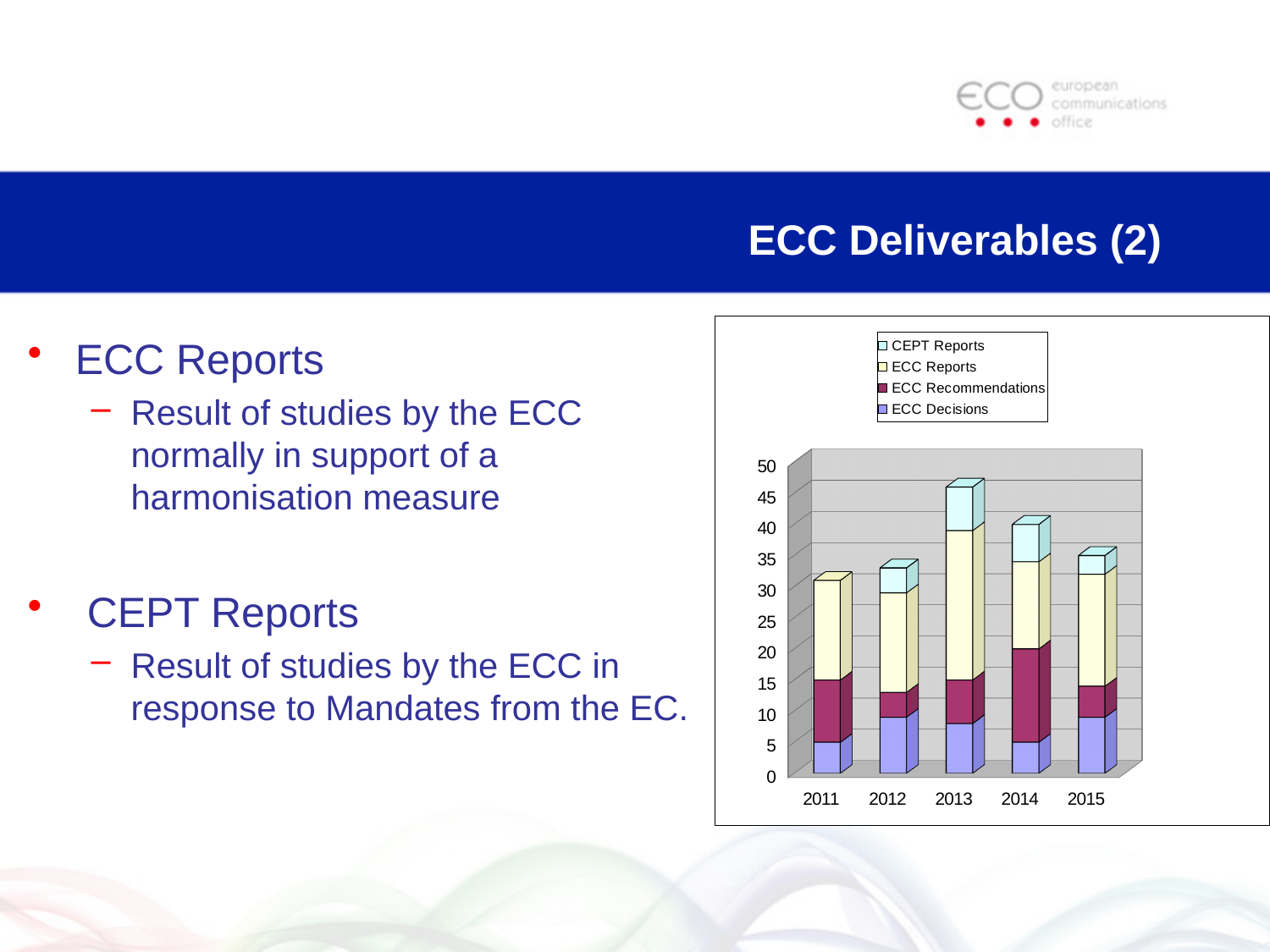
How many series does the chart's legend list? 4 Do the total bar heights rise or fall from 2011 to 2013? rise What kind of chart is shown on the slide? Stacked bar chart Which series is shown at the bottom of each stacked bar? ECC Decisions Which year has the highest total stacked bar? 2013 Is the total for 2014 greater or less than 35? greater How many years are shown on the x axis of the chart? 5 Is the total for 2011 greater or less than 35? less Which series is listed first in the chart's legend? CEPT Reports Which year has the lowest total stacked bar? 2011 Which year has a larger total, 2013 or 2014? 2013 Is the total for 2013 greater or less than 40? greater